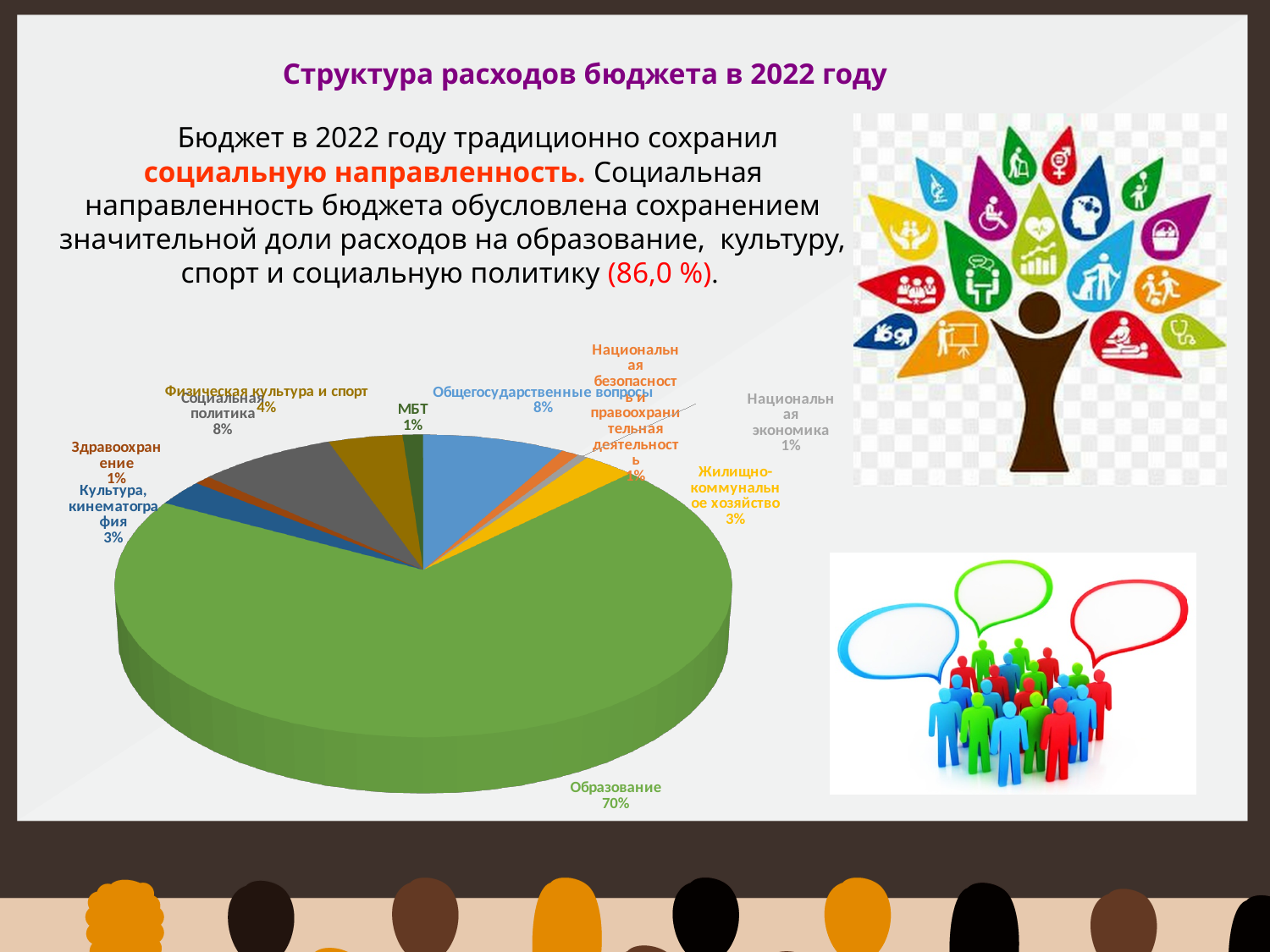
What share of the pie does Образование take? 70% What is the value shown for Физическая культура и спорт? 4% What is the value shown for Здравоохранение? 1% Which is larger, the share for Физическая культура и спорт or the share for Культура, кинематография? Физическая культура и спорт What is the title of the slide containing the pie chart? Структура расходов бюджета в 2022 году How many categories are shown in the pie chart? 10 What is the value shown for Общегосударственные вопросы? 8% What kind of chart is shown on the slide? Pie chart What is the value shown for Жилищно-коммунальное хозяйство? 3% What is the value shown for Социальная политика? 8% What is the difference between the shares of Образование and Социальная политика? 62% Which category has the largest share of the pie? Образование